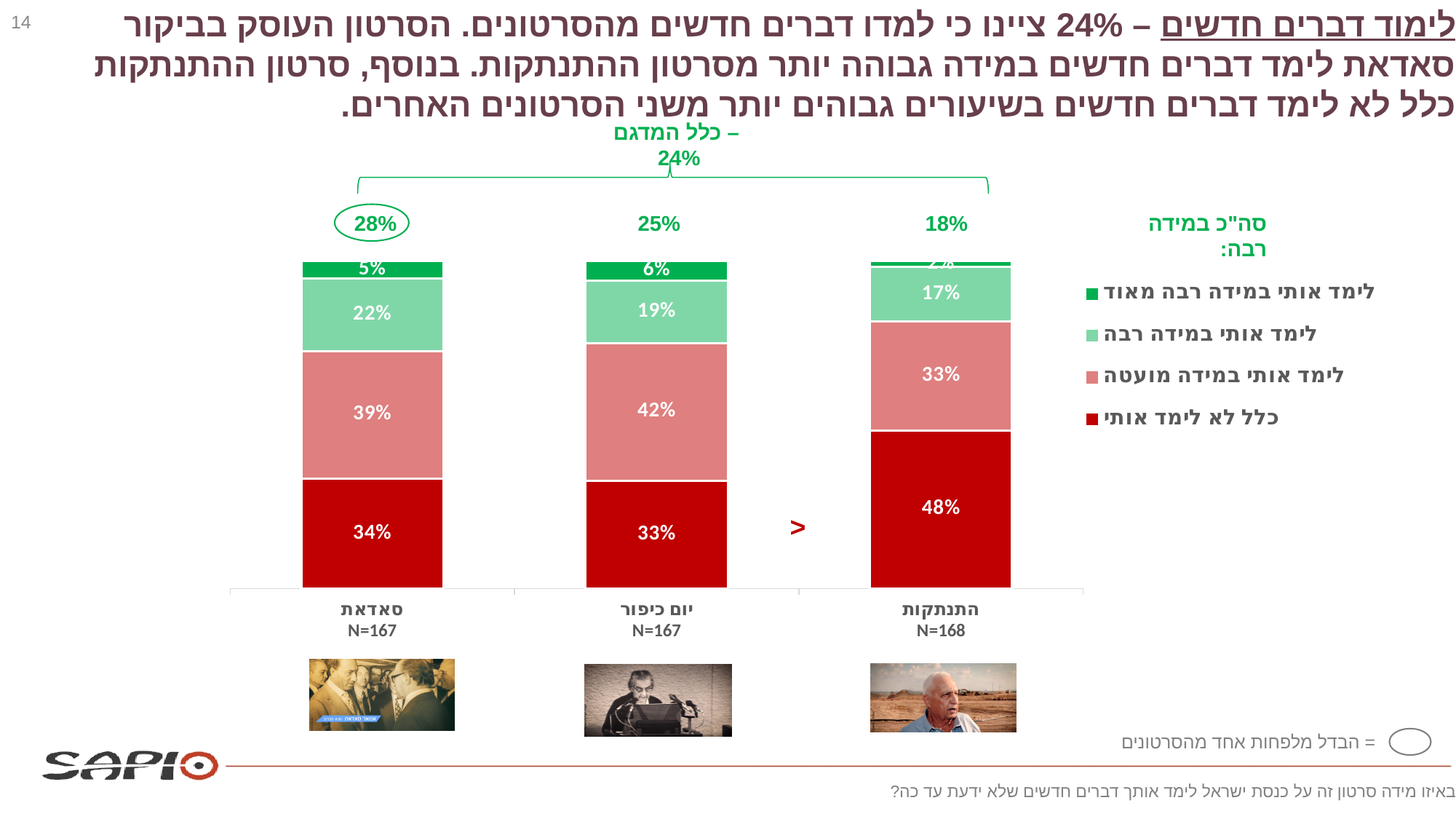
What is the difference between the 'כלל לא לימד אותי' values for התנתקות and יום כיפור? 15% What is the value of 'כלל לא לימד אותי' for התנתקות? 48% What is the value of 'לימד אותי במידה רבה' for סאדאת? 22% What is the value of 'לימד אותי במידה מועטה' for יום כיפור? 42% Which film has the highest 'כלל לא לימד אותי' share? התנתקות How many categories (films) are shown on the x axis? 3 What is the 'סה"כ במידה רבה' total shown above the bar for סאדאת? 28% Which is larger: 'לימד אותי במידה רבה' for סאדאת or for התנתקות? סאדאת What is the sample size (N) shown for התנתקות? N=168 What kind of chart is shown on the slide? stacked bar chart Which film has the lowest 'סה"כ במידה רבה' total? התנתקות How many series does the legend list? 4